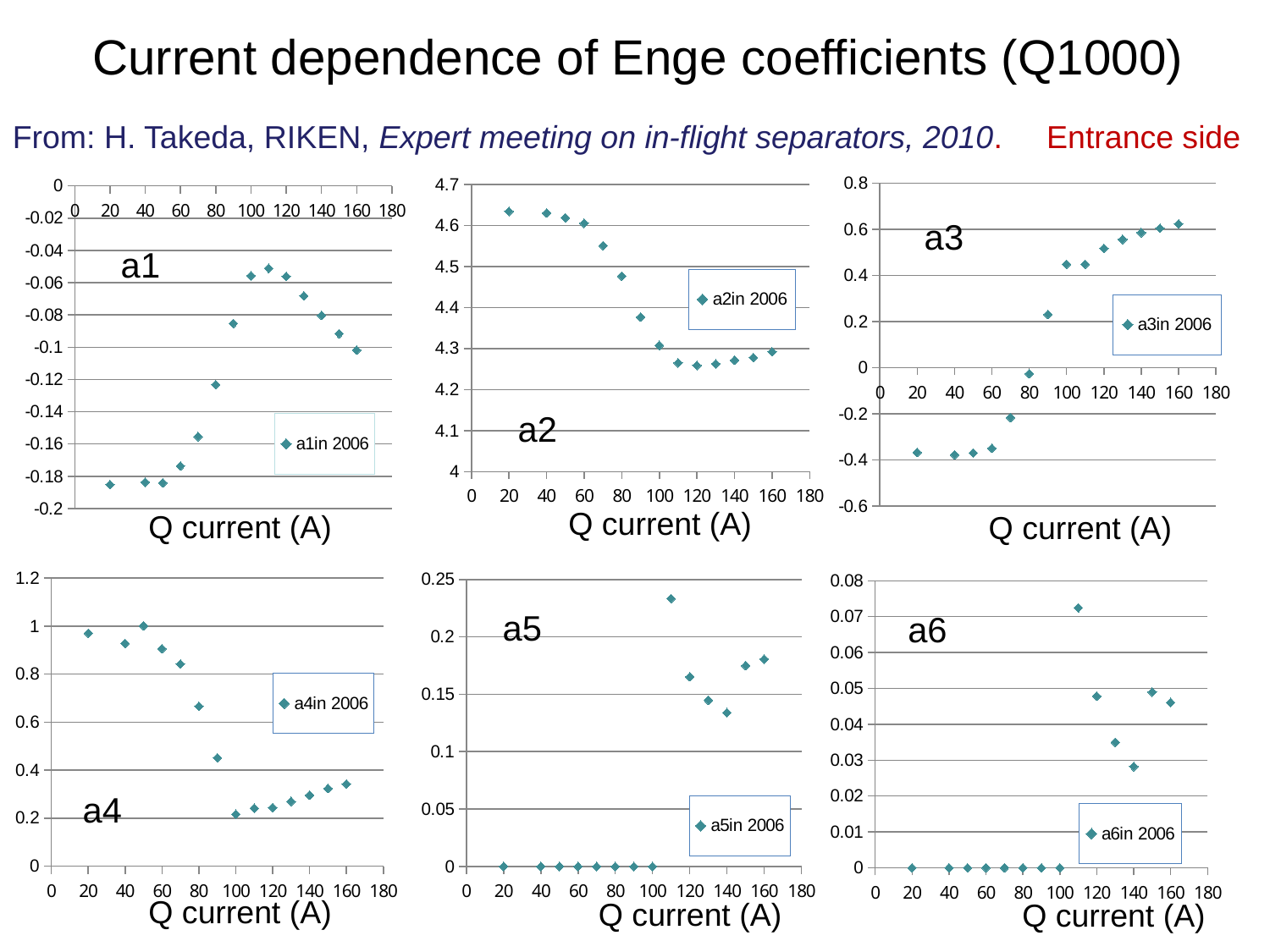
In the a4 chart, at which Q current is the value lowest? 100 A What is the legend entry shown in the a1 chart? a1in 2006 In the a3 chart, is the value at 160 A greater or less than 0.4? greater What kind of chart is the a1 chart? scatter chart In the a6 chart, what is the value at 60 A? 0 In the a4 chart, is the value at 100 A greater or less than 0.4? less In the a6 chart, at which Q current is the value highest? 110 A In the a5 chart, at which Q current is the value highest? 110 A In the a5 chart, what is the value at 20 A? 0 In the a2 chart, is the value at 120 A greater or less than 4.3? less In the a3 chart, do the values generally rise or fall as Q current increases? rise In the a2 chart, which is larger, the value at 20 A or the value at 160 A? 20 A